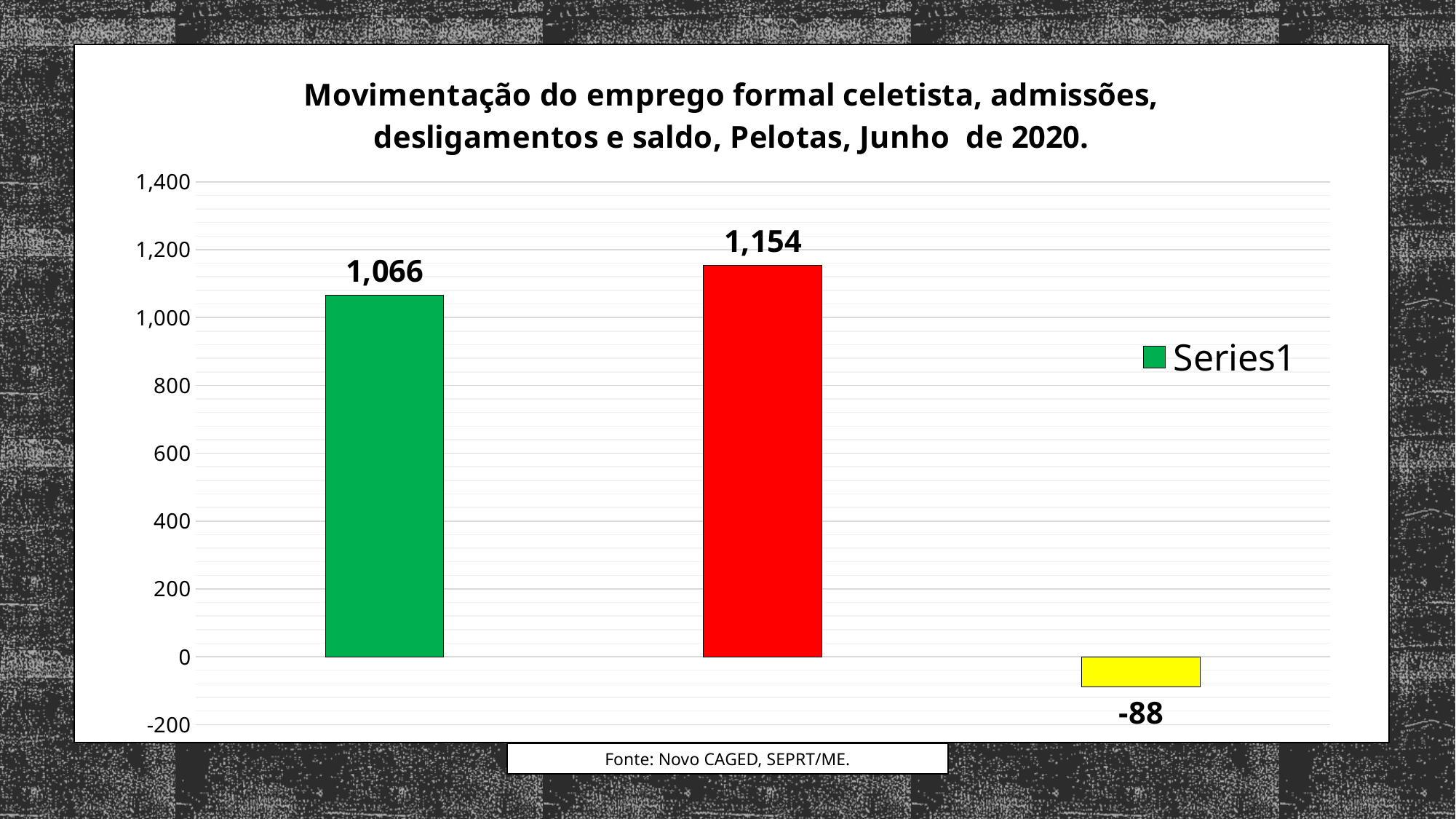
How many bars are plotted in the chart? 3 How many series does the legend list? 1 What is the value of the green bar? 1,066 Which bar has the lowest value: the green, red or yellow one? yellow Which bar has the highest value: the green, red or yellow one? red Is the value of the green bar greater or less than 1,000? greater Which is larger, the value of the green bar or the value of the red bar? red bar What is the difference between the red bar's value and the green bar's value? 88 What is the source cited below the chart? Novo CAGED, SEPRT/ME. What is the value of the red bar? 1,154 What is the value of the yellow bar? -88 What kind of chart is shown on the slide? bar chart